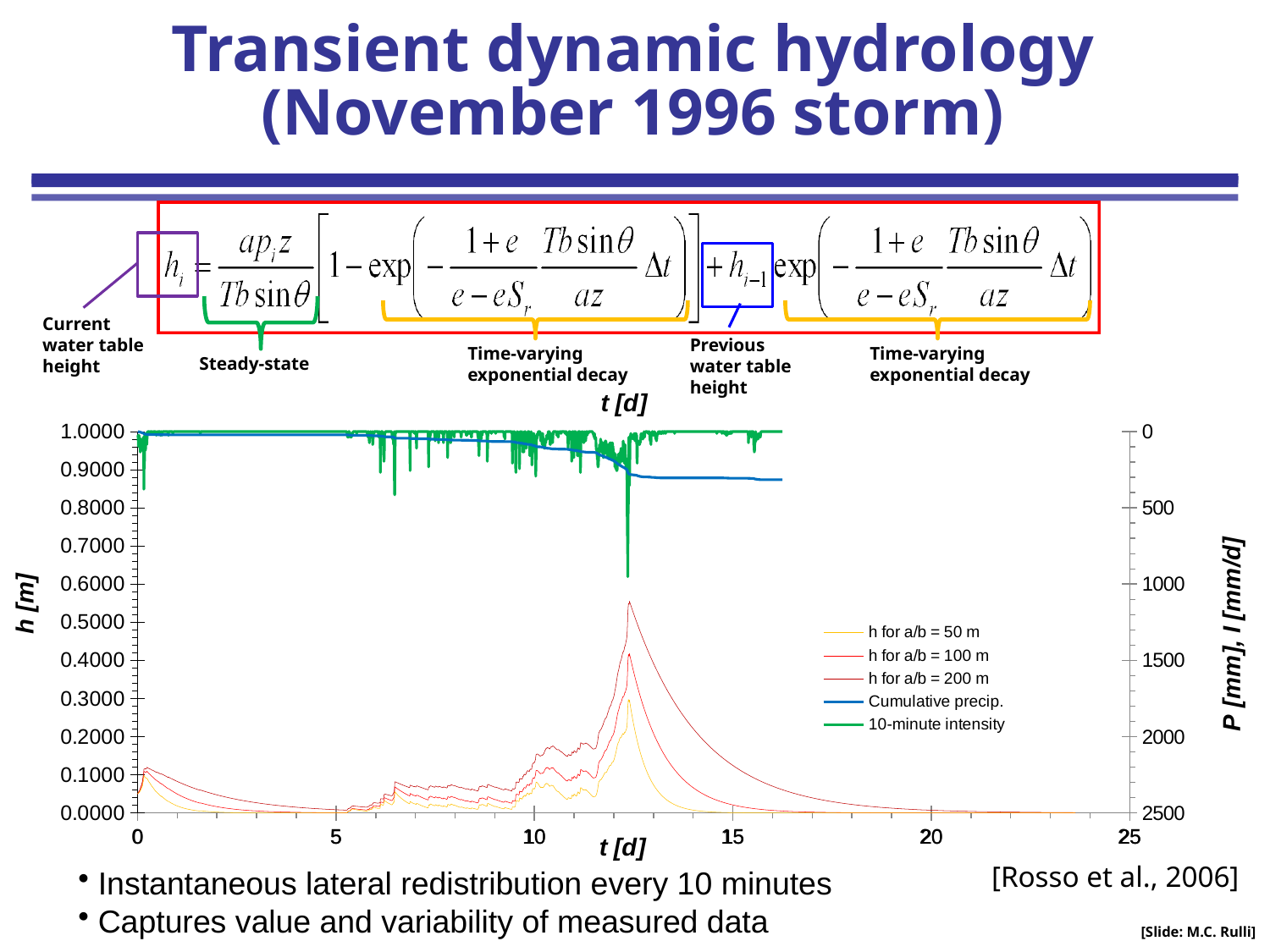
What is the label of the left y axis of the chart? h [m] How many series does the chart legend list? 5 Is the peak value of h for a/b = 200 m greater or less than 0.4000? greater What kind of chart is shown on the slide? Line chart Which of the three h series reaches the highest peak value? h for a/b = 200 m Is the peak value of h for a/b = 50 m greater or less than 0.2000? greater What is the label of the x axis of the chart? t [d] Is the final value of the Cumulative precip. series greater or less than 500 mm? less At its peak, which is larger: h for a/b = 200 m or h for a/b = 50 m? h for a/b = 200 m After its peak near t = 12.5 d, does h for a/b = 200 m rise or fall as t increases? fall Which of the three h series has the lowest peak value? h for a/b = 50 m